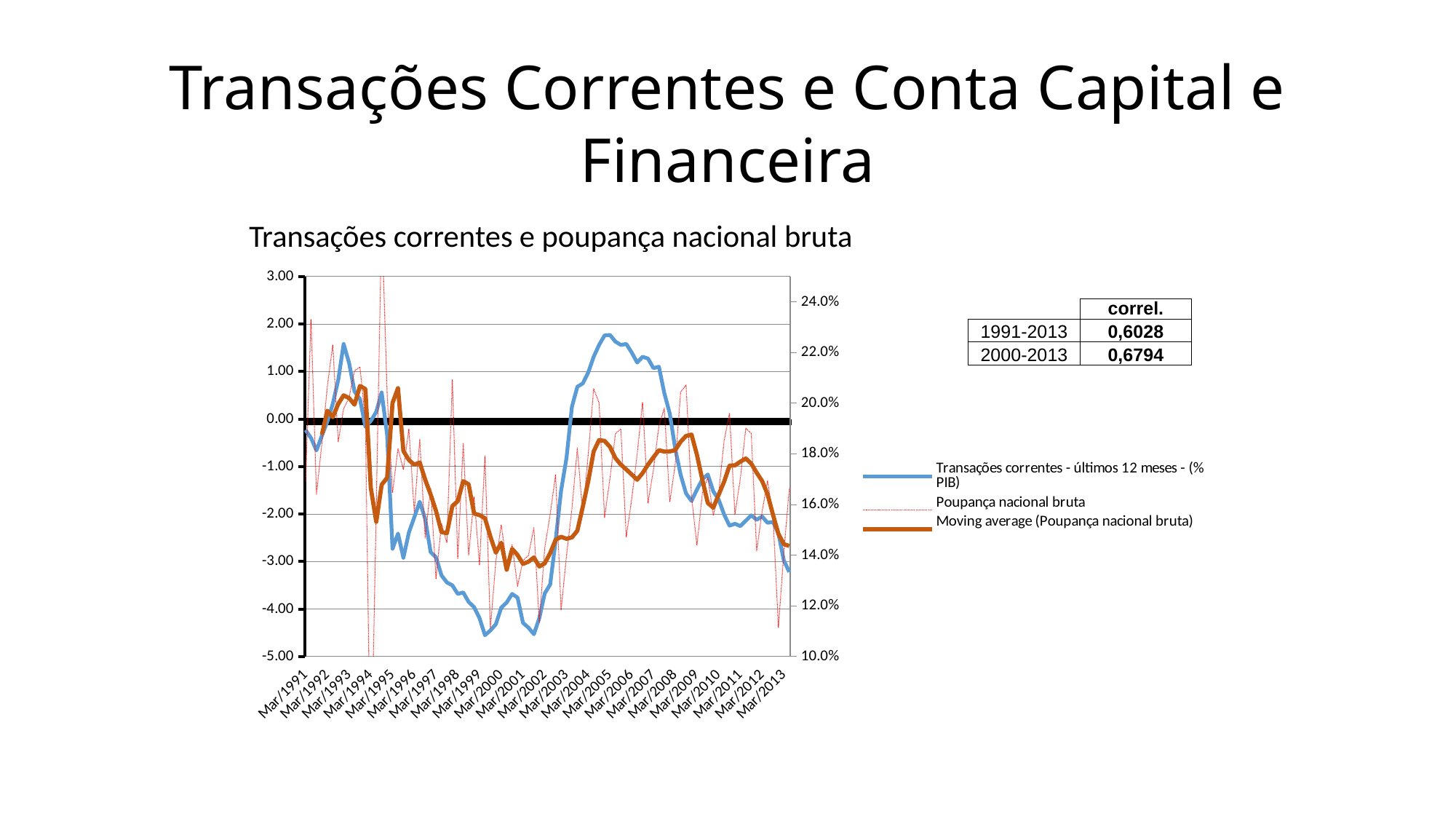
What kind of chart is shown on the slide? line chart Is the value of 'Transações correntes - últimos 12 meses - (% PIB)' at Mar/2013 greater or less than -2.00? less Is the 'Transações correntes - últimos 12 meses - (% PIB)' value higher at Mar/2005 or at Mar/2000? Mar/2005 Which series is drawn as a thin dotted red line? Poupança nacional bruta How many date labels are shown along the x axis? 23 Is the 'Moving average (Poupança nacional bruta)' at Mar/2001 greater or less than 16.0%? less Does the 'Transações correntes - últimos 12 meses - (% PIB)' line rise or fall between Mar/2008 and Mar/2013? fall Is the 'Moving average (Poupança nacional bruta)' at Mar/2008 greater or less than 16.0%? greater How many series does the chart's legend list? 3 What is the title of the chart? Transações correntes e poupança nacional bruta